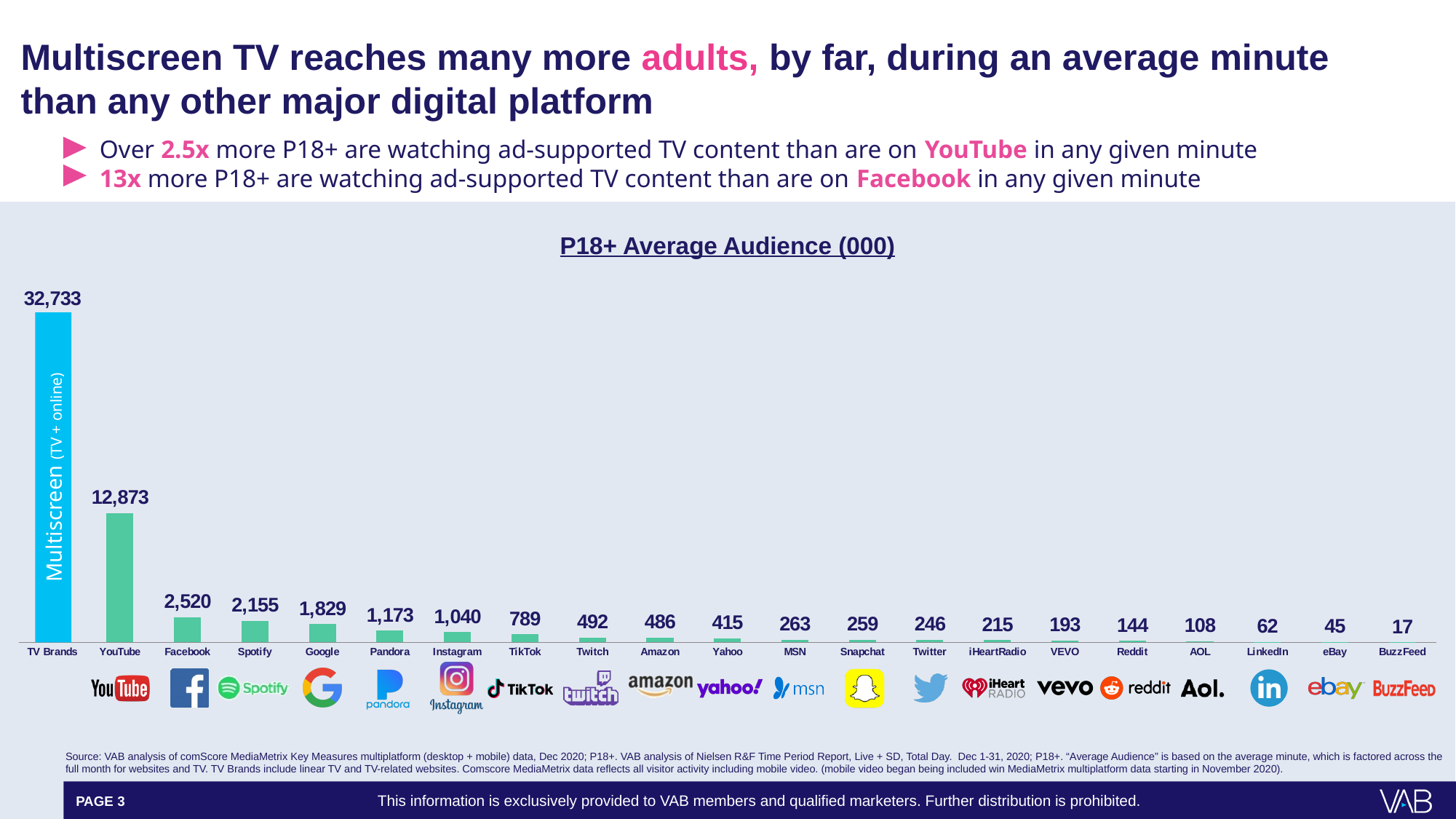
What is the title of the chart? P18+ Average Audience (000) Which has a larger P18+ average audience, Spotify or Google? Spotify Which category has the highest P18+ average audience? TV Brands What is the P18+ average audience (000) for YouTube? 12,873 How many categories are shown in the chart? 21 What kind of chart is shown on the slide? Bar chart What is the P18+ average audience (000) for Reddit? 144 What is the difference between the P18+ average audience (000) for TV Brands and YouTube? 19,860 What is the P18+ average audience (000) for TikTok? 789 What is the P18+ average audience (000) for Facebook? 2,520 What is the P18+ average audience (000) for TV Brands? 32,733 Which category has the lowest P18+ average audience? BuzzFeed